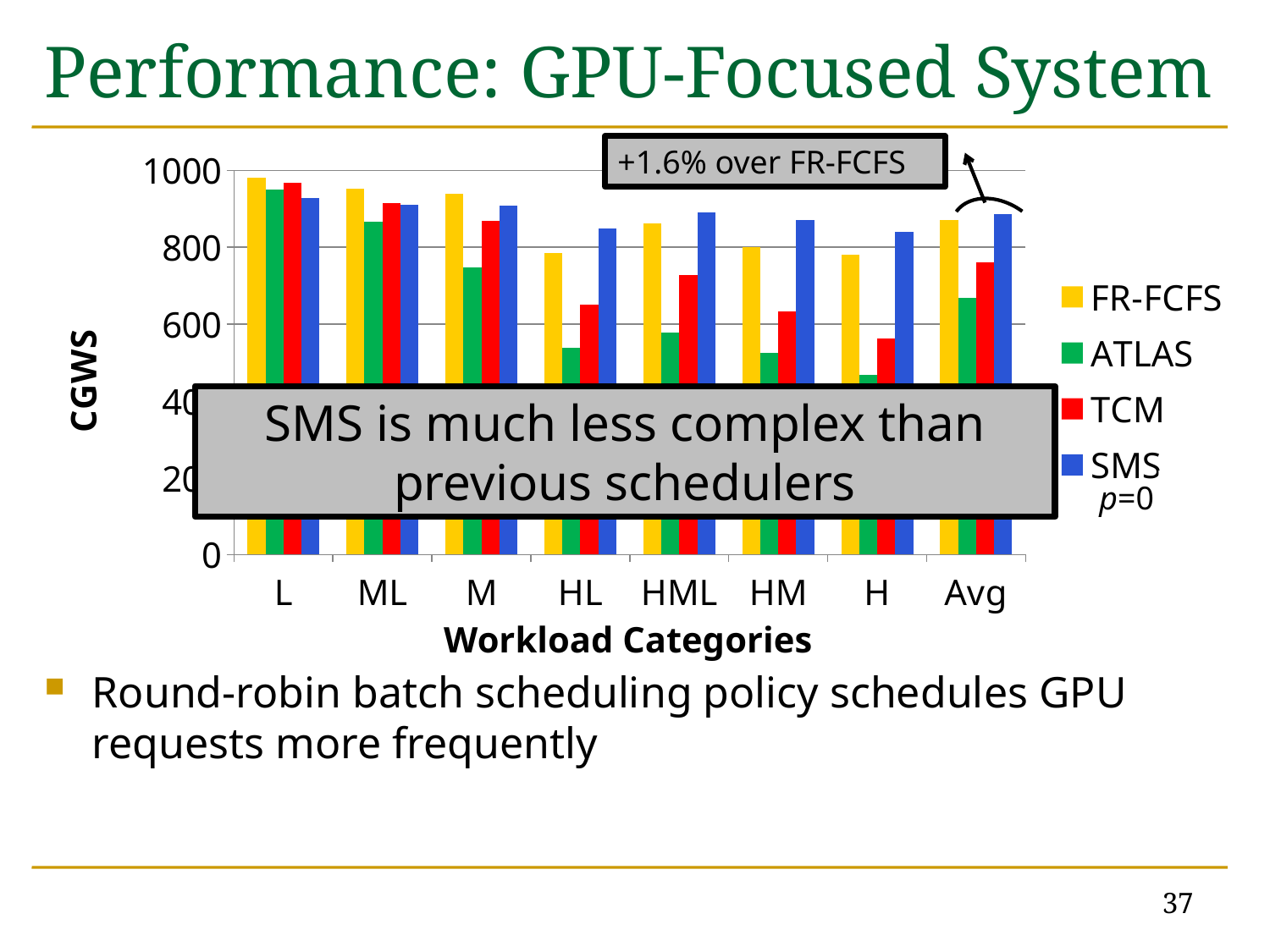
For the HML workload category, which is larger: the ATLAS value or the TCM value? TCM What kind of chart is shown on the slide? bar chart Is the ATLAS value for the HL workload category greater or less than 600? less Is the ATLAS value for the M workload category greater or less than 800? less What is the label of the y axis? CGWS Which series has the lowest value for the HL workload category? ATLAS Is the FR-FCFS value for the L workload category greater or less than 800? greater What improvement over FR-FCFS does the annotation on the chart state? +1.6% over FR-FCFS Which series has the highest value for the HM workload category? SMS How many workload categories are shown on the x axis? 8 How many series does the legend list? 4